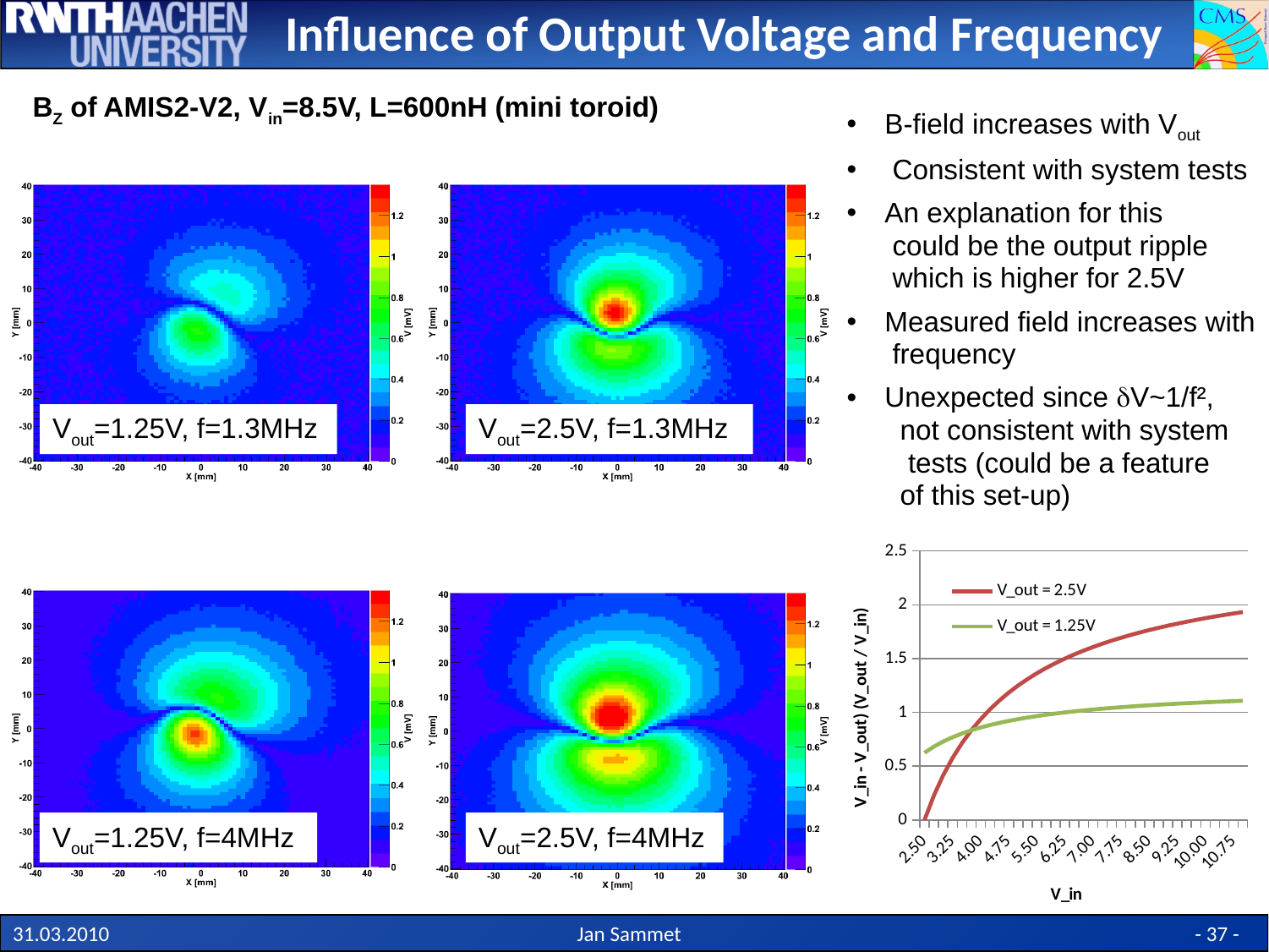
In the bottom-right line chart, which series has the larger value at V_in = 2.50, V_out = 2.5V or V_out = 1.25V? V_out = 1.25V What kind of chart is the plot at the bottom right of the slide with V_in on the x axis? line chart In the bottom-right line chart, what are the two series named in the legend? V_out = 2.5V and V_out = 1.25V In the bottom-right line chart, does the V_out = 2.5V series rise or fall as V_in increases? rise In the bottom-right line chart, how many tick labels are shown on the V_in axis? 12 How many 2D colour-map plots of B_z are shown on the slide? 4 In the bottom-right line chart, is the value of the V_out = 1.25V series at V_in = 10.75 greater or less than 1.5? less In the bottom-right line chart, does the V_out = 1.25V series rise or fall as V_in increases? rise In the line chart at the bottom right, how many series does the legend list? 2 In the bottom-right line chart, is the value of the V_out = 2.5V series at V_in = 2.50 greater or less than 0.5? less In the bottom-right line chart, which series has the larger value at V_in = 10.00, V_out = 2.5V or V_out = 1.25V? V_out = 2.5V In the bottom-right line chart, is the value of the V_out = 2.5V series at V_in = 10.75 greater or less than 1.5? greater